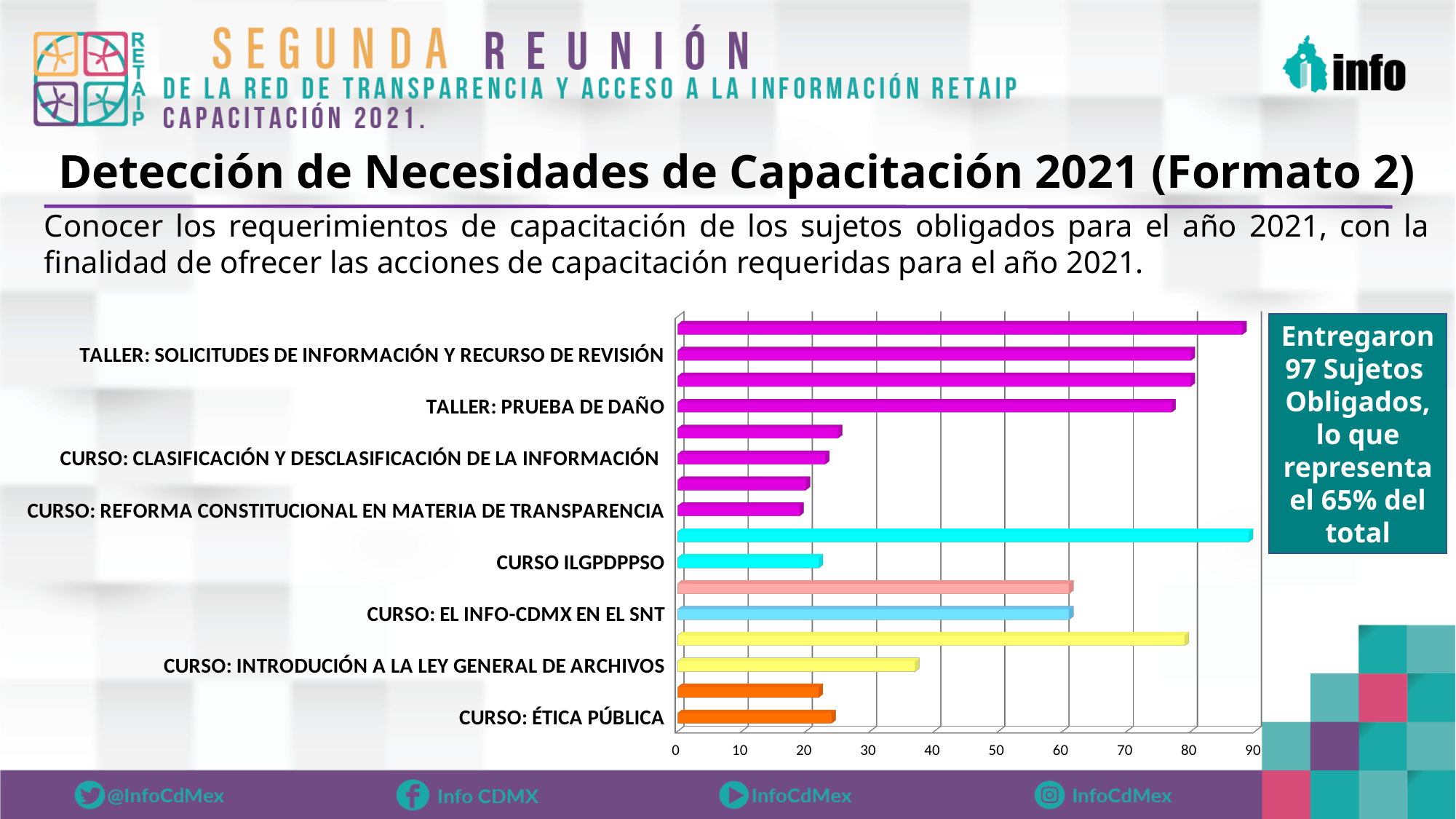
According to the text box next to the chart, how many Sujetos Obligados submitted the format? 97 Is the value for CURSO: EL INFO-CDMX EN EL SNT greater or less than 50? greater How many category labels are listed on the vertical axis of the chart? 8 Is the value for TALLER: PRUEBA DE DAÑO greater or less than 70? greater Is the value for CURSO: ÉTICA PÚBLICA greater or less than 30? less Which has the larger value, CURSO: ÉTICA PÚBLICA or CURSO: EL INFO-CDMX EN EL SNT? CURSO: EL INFO-CDMX EN EL SNT Which has the larger value, TALLER: PRUEBA DE DAÑO or CURSO: REFORMA CONSTITUCIONAL EN MATERIA DE TRANSPARENCIA? TALLER: PRUEBA DE DAÑO What kind of chart is shown on the slide? bar chart What is the highest value shown on the horizontal axis of the chart? 90